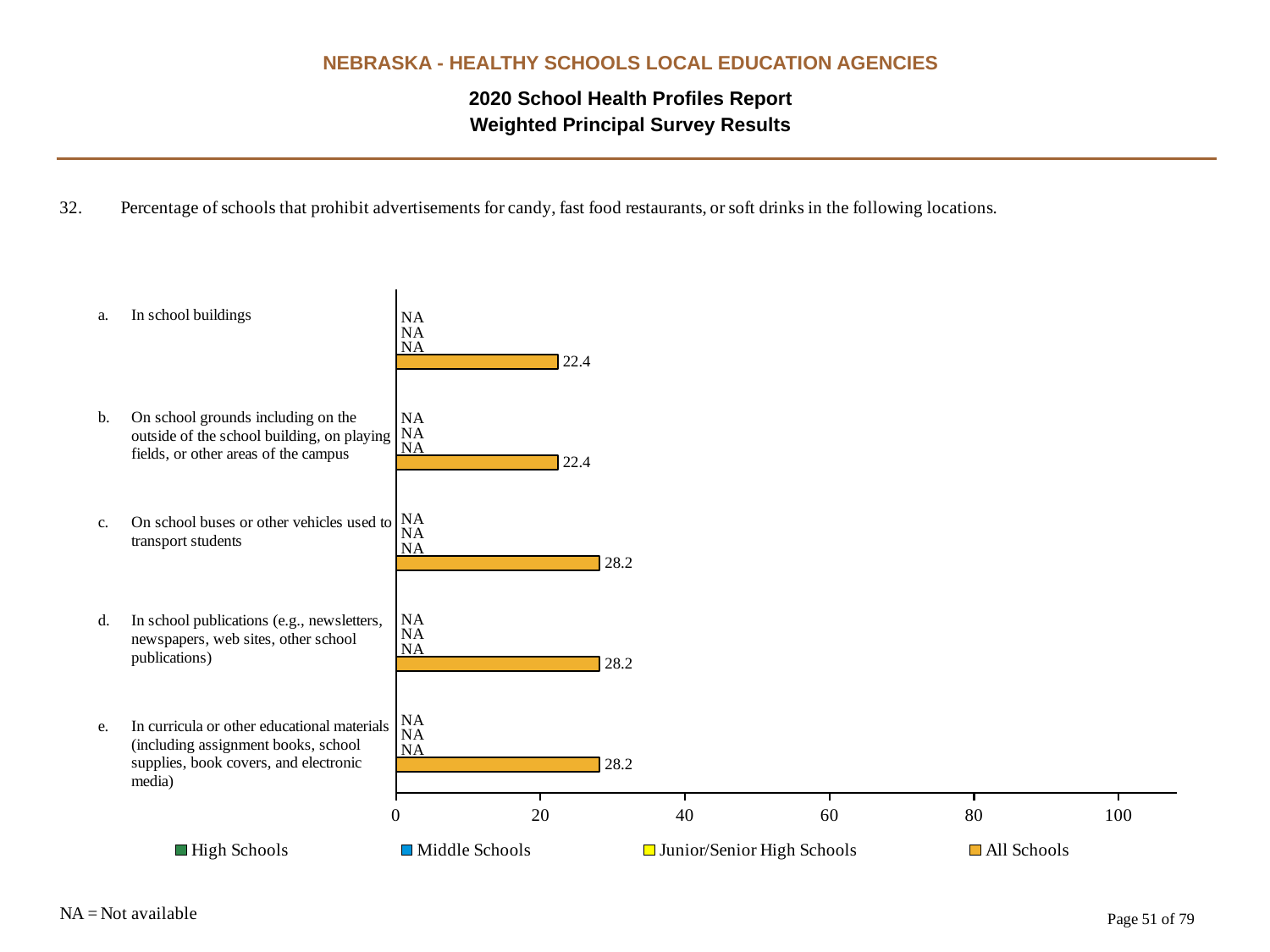
What is the All Schools value for 'In school publications (e.g., newsletters, newspapers, web sites, other school publications)'? 28.2 How many locations (categories) are listed in the chart? 5 What kind of chart is shown on the slide? bar chart What is the All Schools value for 'In curricula or other educational materials'? 28.2 What does NA stand for according to the note on the slide? Not available What is the All Schools value for 'In school buildings'? 22.4 How many series does the legend list? 4 Which is larger for All Schools: 'On school grounds including on the outside of the school building, on playing fields, or other areas of the campus' or 'In school publications'? In school publications What is the All Schools value for 'On school buses or other vehicles used to transport students'? 28.2 What value is shown for High Schools for 'In school buildings'? NA What is the difference between the All Schools values for 'On school buses or other vehicles used to transport students' and 'In school buildings'? 5.8 Is the All Schools value for 'In school buildings' greater or less than 40? less